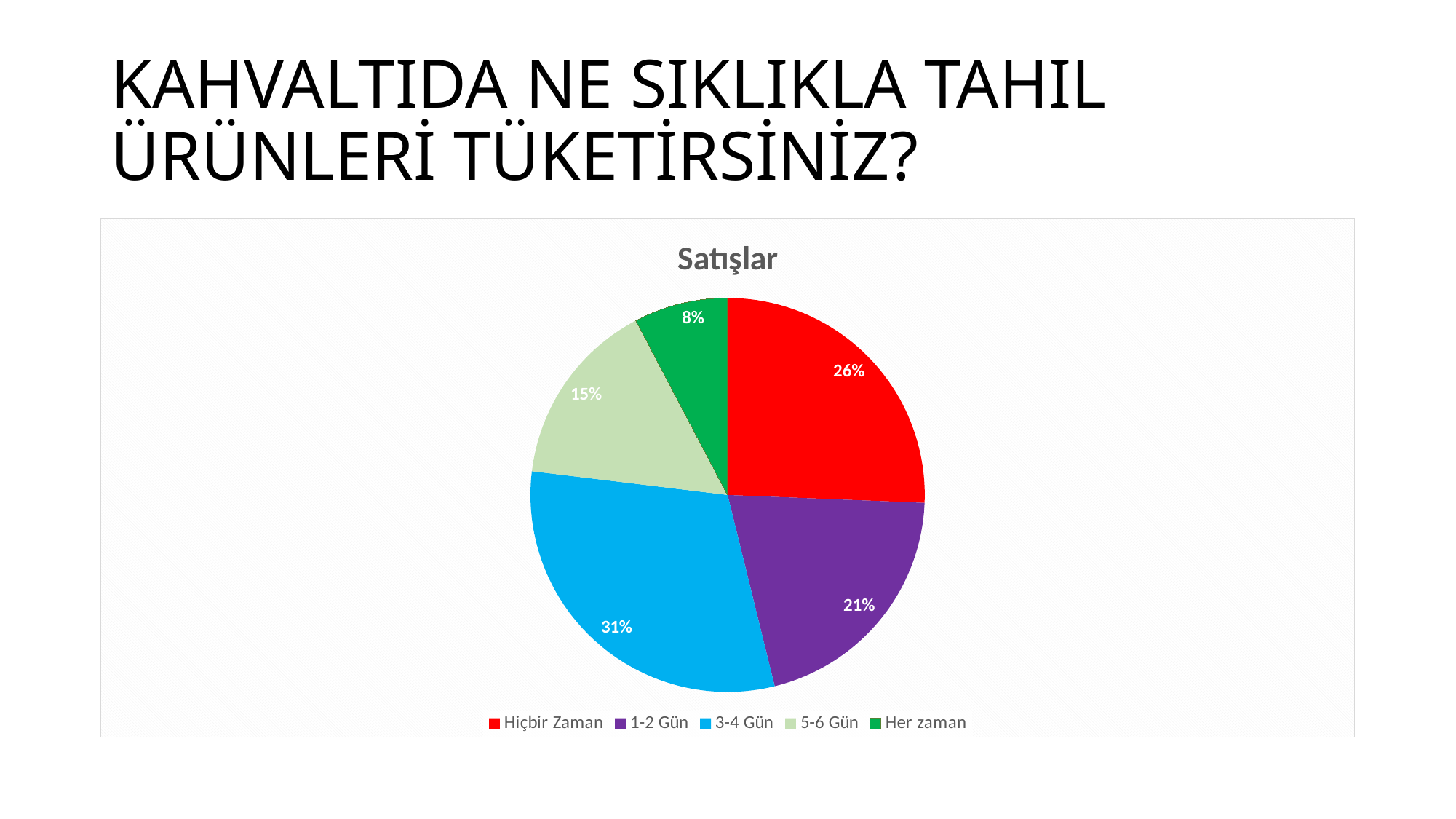
What share of the pie does the 'Hiçbir Zaman' slice represent? 26% What is the difference between the '3-4 Gün' and 'Hiçbir Zaman' shares? 5% Which is larger, the '1-2 Gün' slice or the '5-6 Gün' slice? 1-2 Gün What share of the pie does the 'Her zaman' slice represent? 8% What is the value for '1-2 Gün'? 21% What share of the pie does the '3-4 Gün' slice represent? 31% Which category has the largest slice? 3-4 Gün What is the value for '5-6 Gün'? 15% Which category has the smallest slice? Her zaman How many categories does the legend list? 5 What kind of chart is shown on the slide? pie chart What is the chart's title? Satışlar